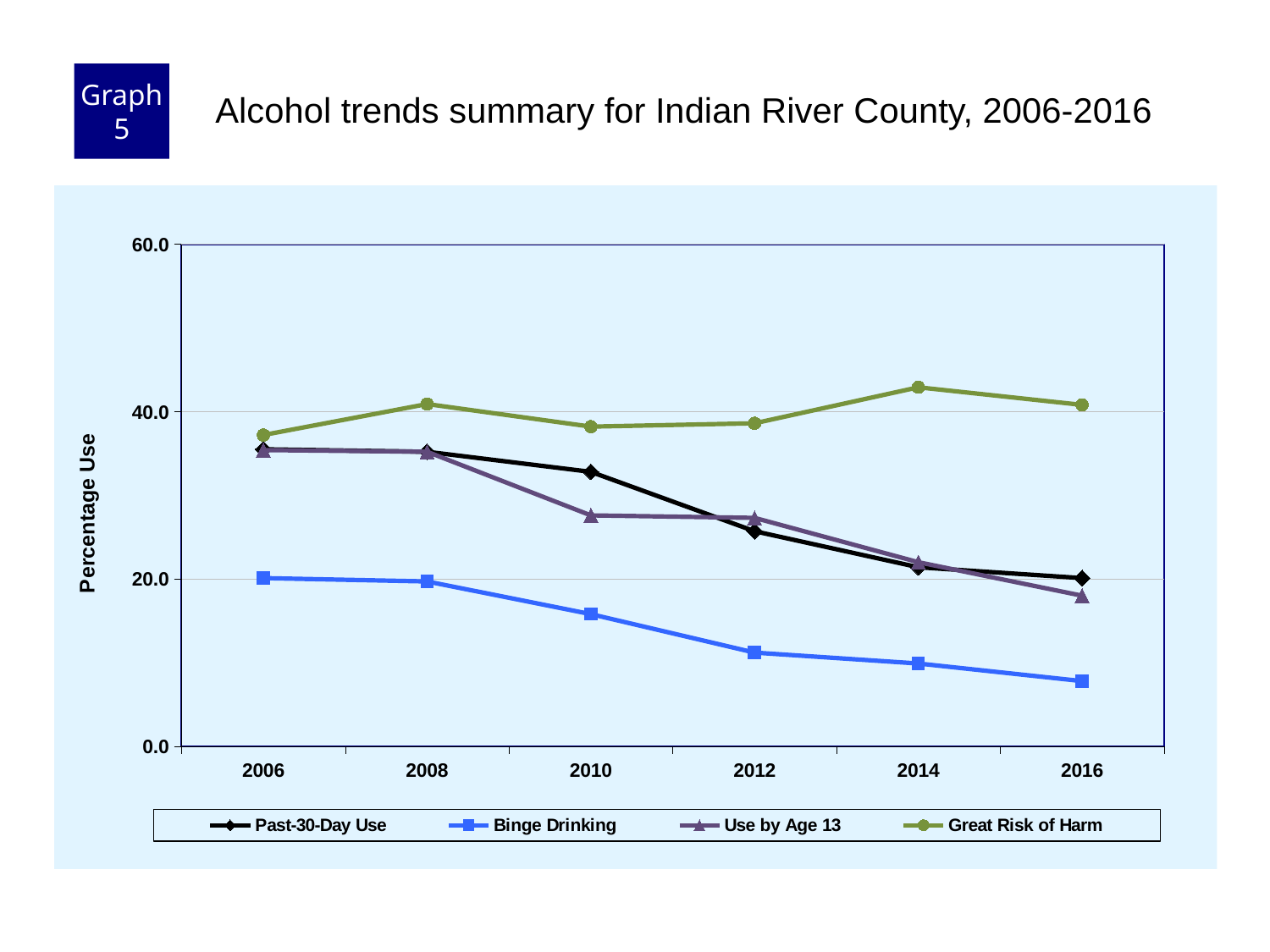
Which series has the highest value in 2016? Great Risk of Harm Which series has the lowest value in 2006? Binge Drinking What is the label on the y axis? Percentage Use Is the value for Past-30-Day Use in 2006 greater or less than 40.0? less How many series does the legend list? 4 In 2010, which is larger: Past-30-Day Use or Use by Age 13? Past-30-Day Use Is the value for Great Risk of Harm in 2014 greater or less than 40.0? greater Does the Past-30-Day Use series rise or fall from 2006 to 2016? Falls Does the Binge Drinking series rise or fall from 2006 to 2016? Falls What kind of chart is shown on the slide? Line chart How many years are plotted along the x axis? 6 Is the value for Binge Drinking in 2016 greater or less than 20.0? less